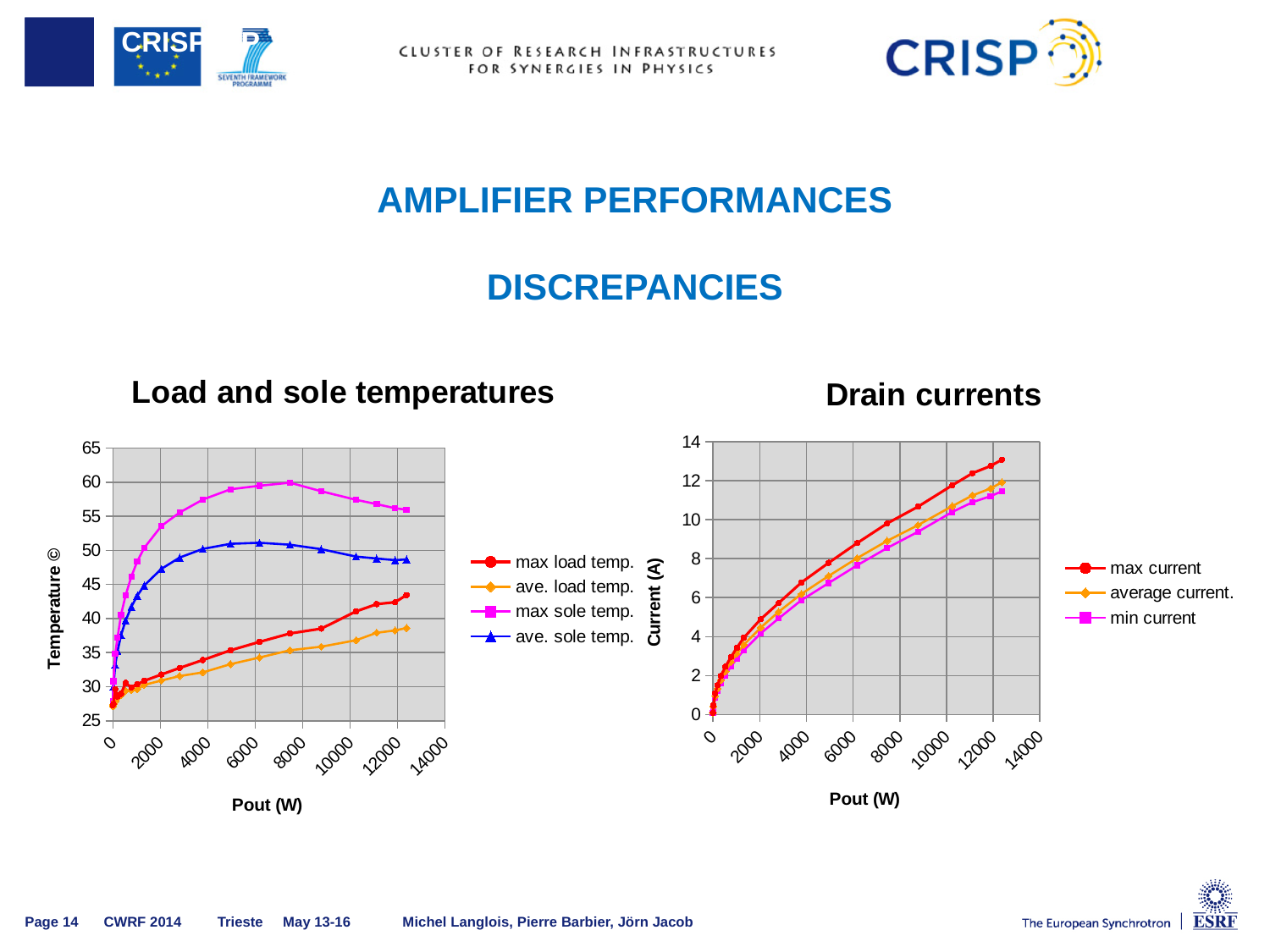
In the "Load and sole temperatures" chart, is the ave. load temp at 12000 W greater or less than 40? less In the "Drain currents" chart, is the max current at 4000 W greater or less than 6? greater In the "Drain currents" chart, does the max current rise or fall as Pout increases? rise In the "Load and sole temperatures" chart, what is the title of the x axis? Pout (W) How many series does the legend of the "Load and sole temperatures" chart list? 4 In the "Load and sole temperatures" chart, is the max load temp at 12000 W greater or less than 40? greater In the "Drain currents" chart, which is higher at 8000 W: max current or min current? max current In the "Load and sole temperatures" chart, which is higher at 6000 W: max sole temp or max load temp? max sole temp What kind of chart is the "Drain currents" chart? line chart In the "Drain currents" chart, what is the title of the y axis? Current (A) How many series does the legend of the "Drain currents" chart list? 3